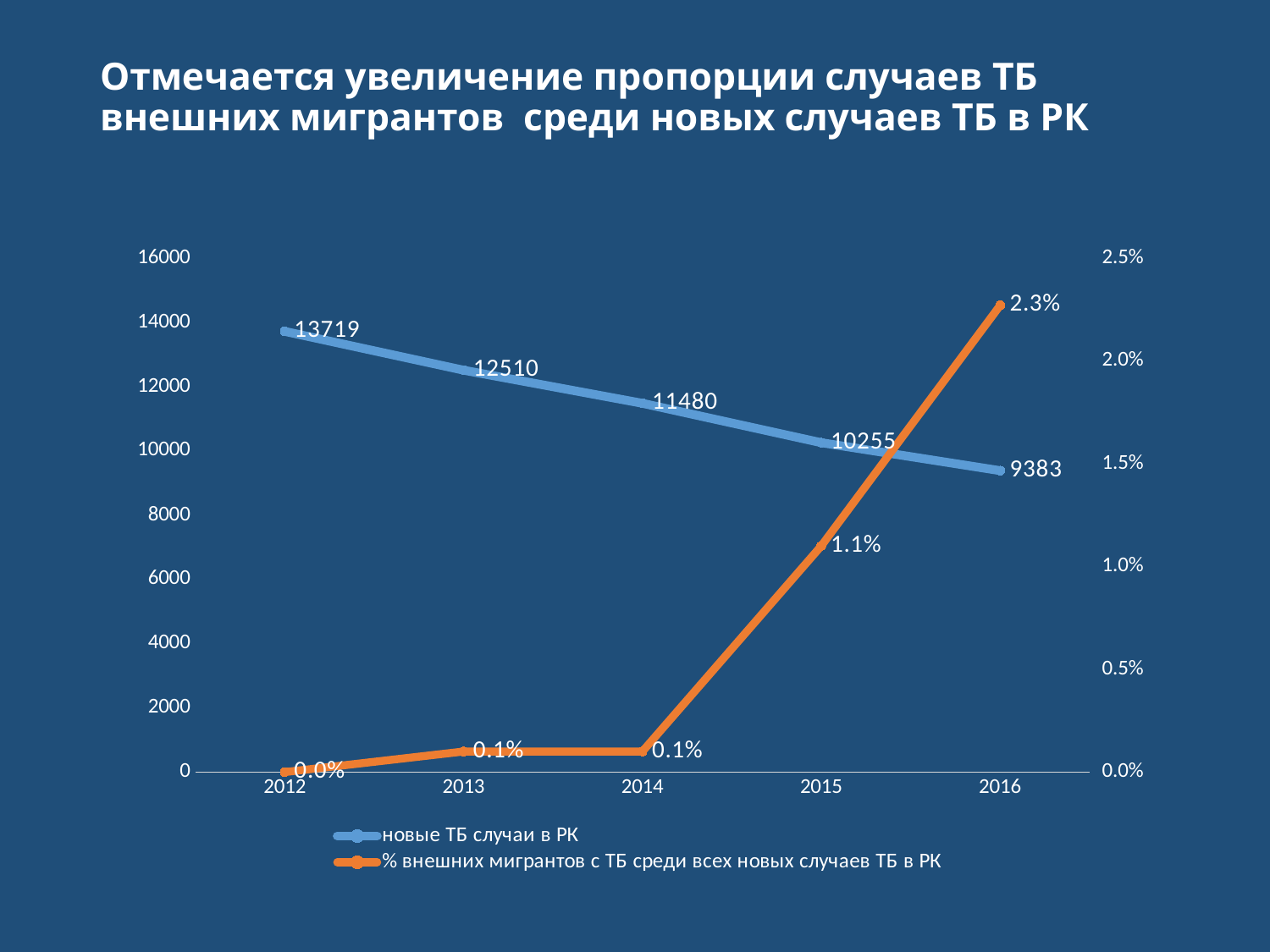
In which year was the percentage of external migrants with TB among new TB cases lowest? 2012 What is the difference in new TB cases in RK between 2013 and 2014? 1030 Which year had more new TB cases in RK, 2014 or 2015? 2014 What was the number of new TB cases in RK (новые ТБ случаи в РК) in 2012? 13719 What percentage of external migrants with TB among all new TB cases in RK is shown for 2016? 2.3% In which year was the number of new TB cases in RK highest? 2012 What kind of chart is shown on the slide? Line chart What percentage of external migrants with TB among all new TB cases in RK is shown for 2015? 1.1% How many series does the legend list? 2 How many years are shown on the x axis? 5 By how much did the number of new TB cases in RK decrease from 2012 to 2016? 4336 What was the number of new TB cases in RK in 2016? 9383